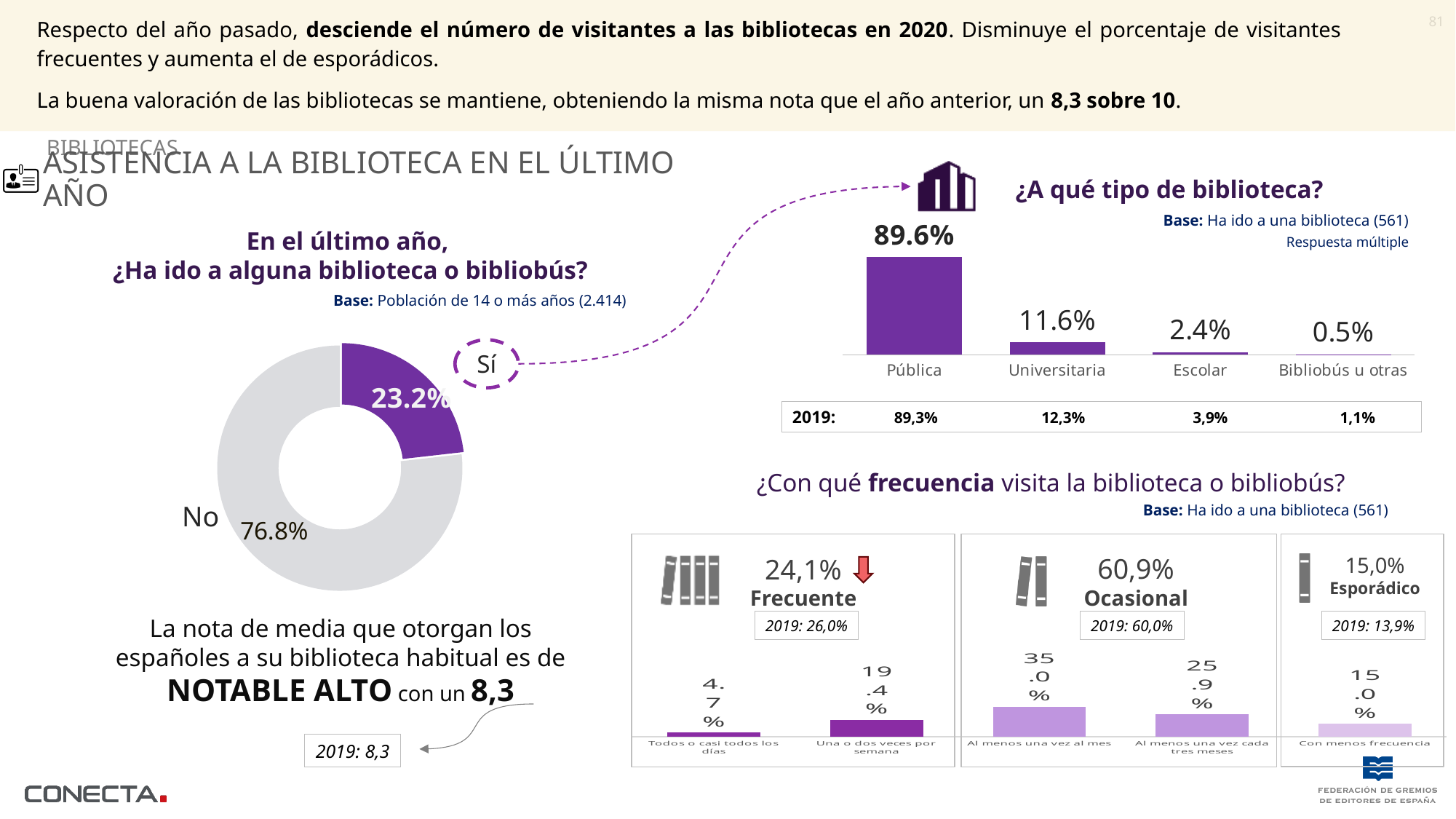
What kind of chart is used for '¿Ha ido a alguna biblioteca o bibliobús?'? Donut (pie) chart In the donut chart '¿Ha ido a alguna biblioteca o bibliobús?', what percentage answered Sí? 23.2% In the bar chart '¿A qué tipo de biblioteca?', how many categories are shown? 4 In the bar chart '¿A qué tipo de biblioteca?', which category has the lowest value? Bibliobús u otras In the bar chart '¿A qué tipo de biblioteca?', what is the value for Pública? 89.6% In the frequency chart '¿Con qué frecuencia visita la biblioteca o bibliobús?', what is the value for 'Una o dos veces por semana'? 19.4% In the bar chart '¿A qué tipo de biblioteca?', what is the value for Universitaria? 11.6% In the frequency chart '¿Con qué frecuencia visita la biblioteca o bibliobús?', what is the value for 'Todos o casi todos los días'? 4.7% In the bar chart '¿A qué tipo de biblioteca?', what is the difference between Universitaria and Escolar? 9.2 percentage points In the frequency chart '¿Con qué frecuencia visita la biblioteca o bibliobús?', which is larger: 'Al menos una vez al mes' or 'Al menos una vez cada tres meses'? Al menos una vez al mes In the bar chart '¿A qué tipo de biblioteca?', what kind of chart is it? Bar chart In the donut chart '¿Ha ido a alguna biblioteca o bibliobús?', what percentage answered No? 76.8%